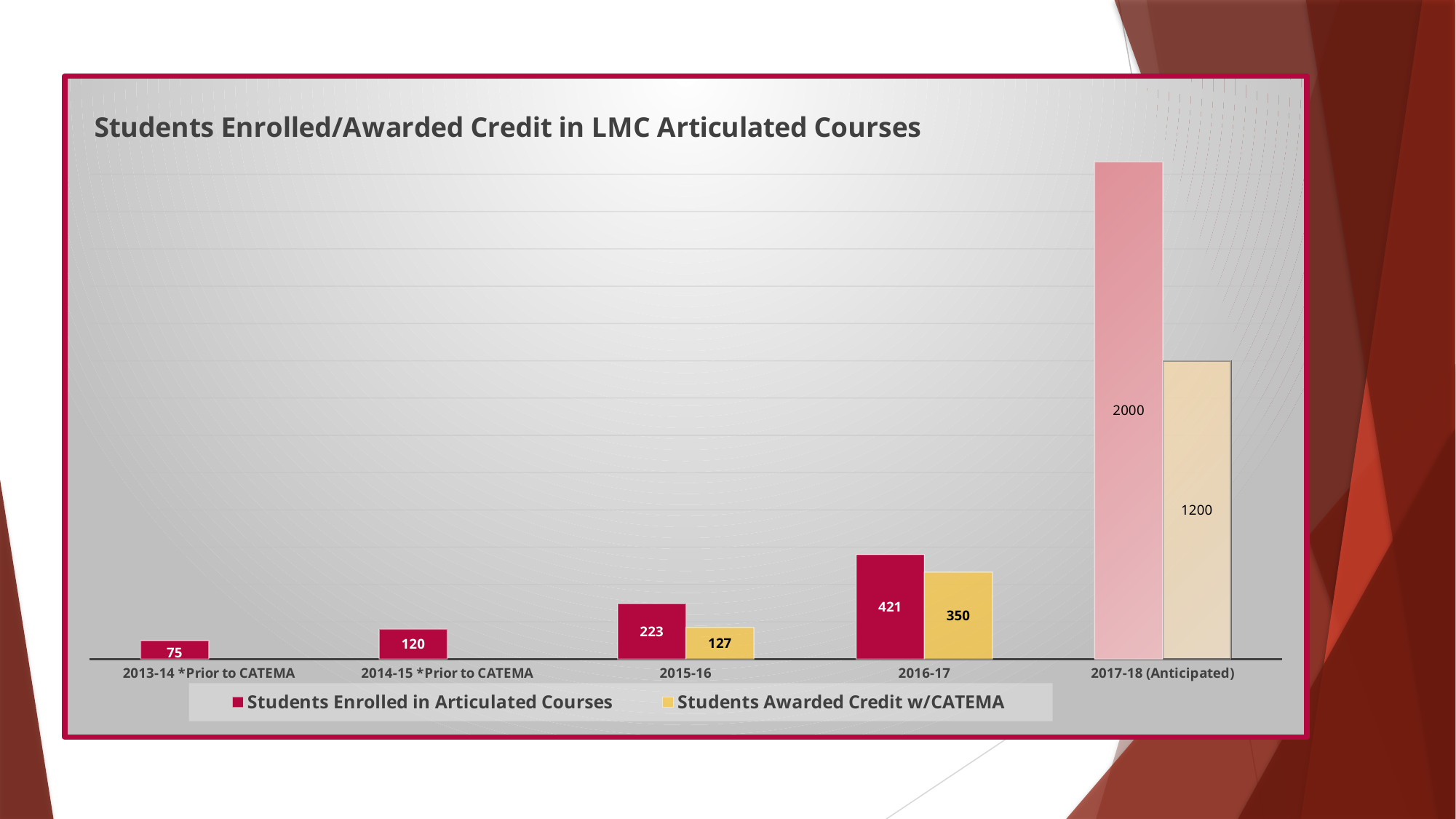
What kind of chart is shown on the slide? Bar chart What is the value for Students Enrolled in Articulated Courses in 2013-14 *Prior to CATEMA? 75 Which is larger in 2015-16: Students Enrolled in Articulated Courses or Students Awarded Credit w/CATEMA? Students Enrolled in Articulated Courses What is the value for Students Awarded Credit w/CATEMA in 2016-17? 350 How many series does the legend list? 2 Which category has the highest value for Students Enrolled in Articulated Courses? 2017-18 (Anticipated) What is the difference between the anticipated 2017-18 values for Students Enrolled in Articulated Courses and Students Awarded Credit w/CATEMA? 800 How many categories are shown on the x axis? 5 What is the anticipated number of Students Enrolled in Articulated Courses for 2017-18? 2000 What is the difference between Students Enrolled in Articulated Courses and Students Awarded Credit w/CATEMA in 2016-17? 71 What is the value for Students Enrolled in Articulated Courses in 2015-16? 223 Which category has the lowest value for Students Enrolled in Articulated Courses? 2013-14 *Prior to CATEMA